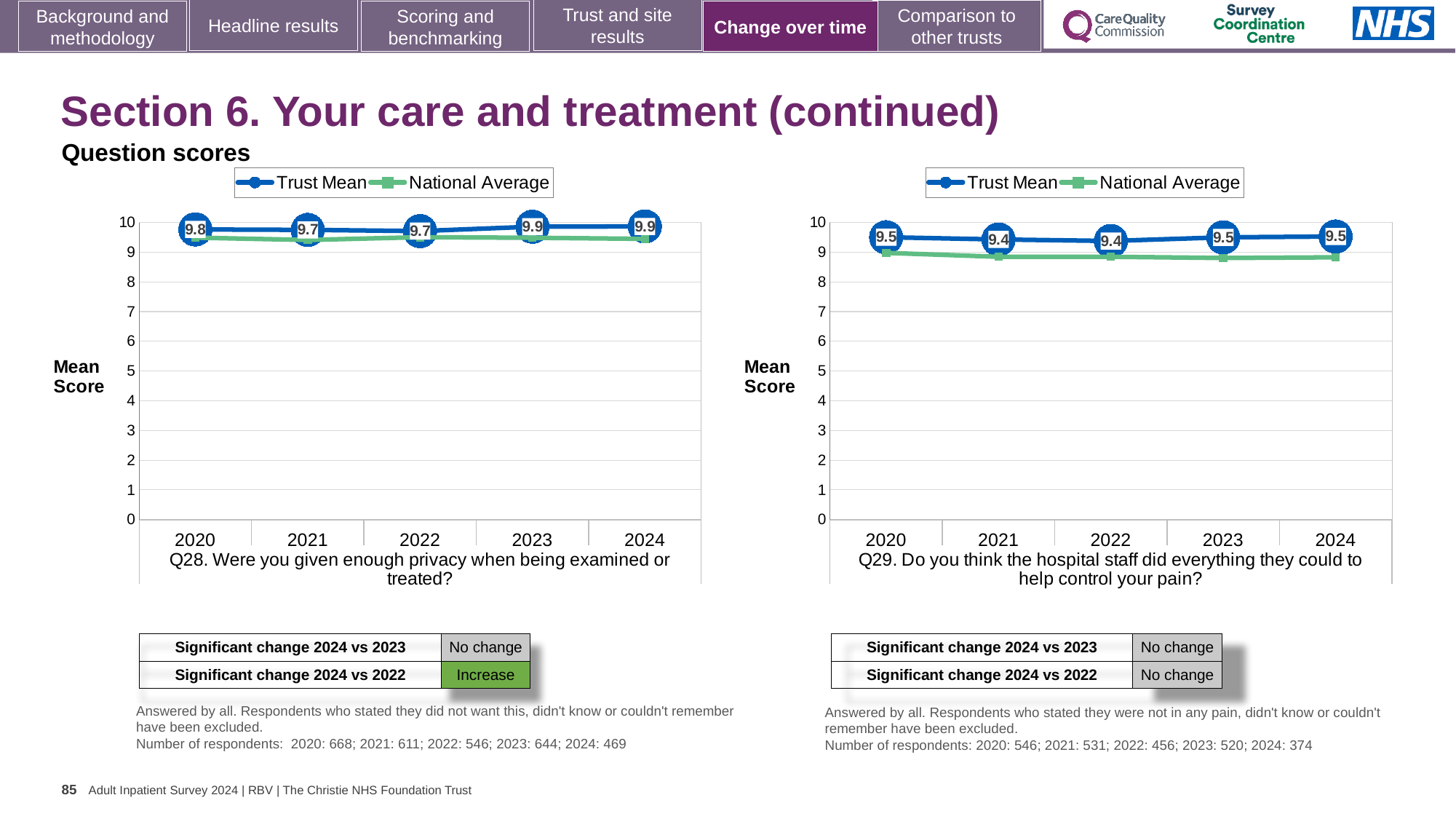
In the Q29 chart (right), which is larger: the Trust Mean for 2020 or the Trust Mean for 2022? 2020 What kind of chart is the Q28 chart (left)? Line chart How many years are plotted on the x axis of the Q28 chart (left)? 5 In the Q29 chart (right), what is the Trust Mean for 2024? 9.5 In the Q29 chart (right), what is the Trust Mean for 2021? 9.4 In the Q28 chart (left), is the National Average for 2020 greater or less than 9? greater In the Q28 chart (left), what is the Trust Mean for 2020? 9.8 In the Q29 chart (right), is the National Average for 2024 greater or less than 9? less In the Q28 chart (left), what is the difference between the Trust Mean for 2024 and the Trust Mean for 2021? 0.2 How many series does the legend of the Q29 chart (right) list? 2 In the Q28 chart (left), what is the Trust Mean for 2023? 9.9 What are the two series named in the legend of the Q28 chart (left)? Trust Mean and National Average